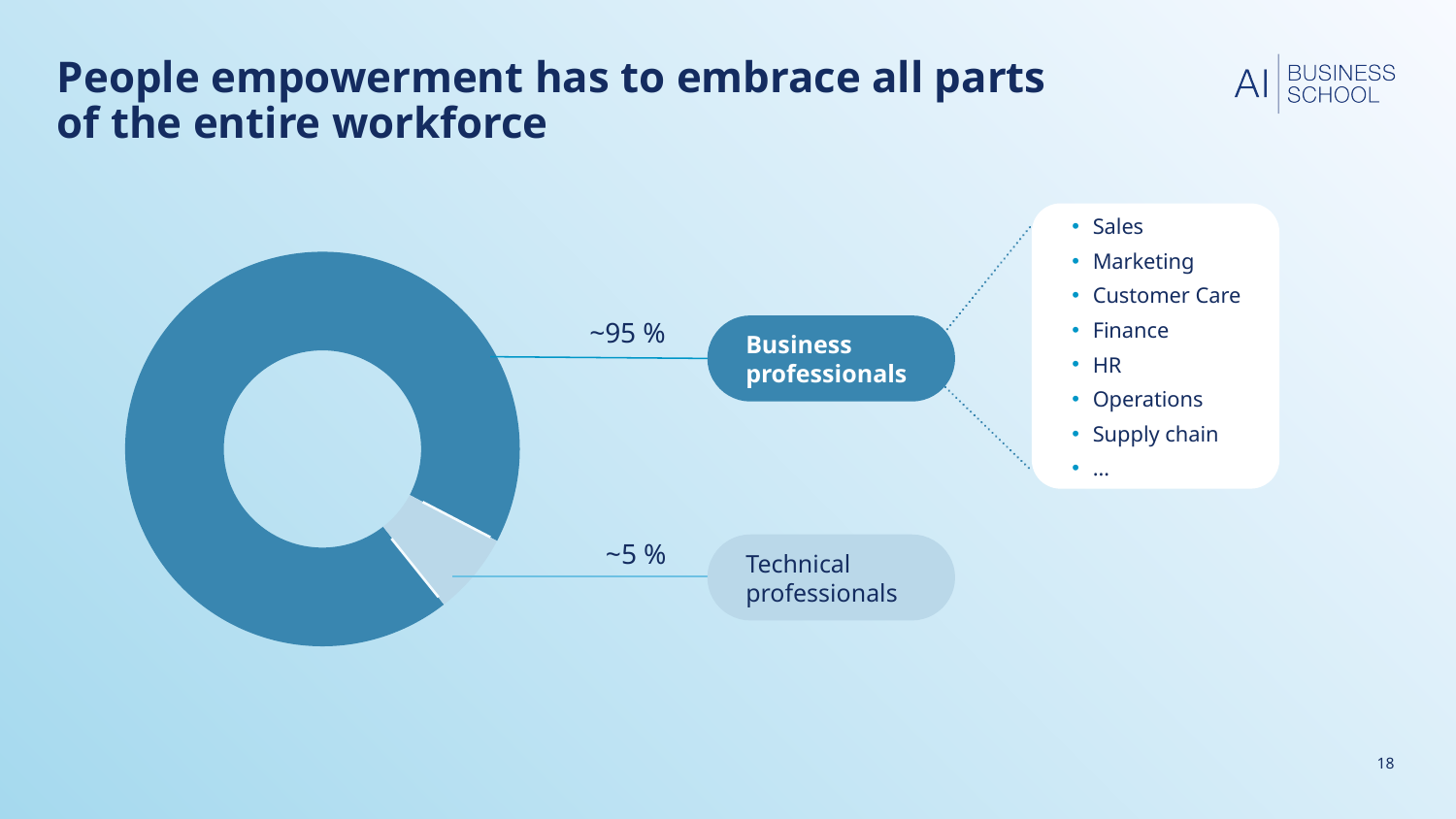
What value is labelled for the Technical professionals slice? ~5 % Which is larger in the pie chart, Business professionals or Technical professionals? Business professionals What value is labelled for the Business professionals slice? ~95 % Which slice of the pie chart is the smallest? Technical professionals What is the title of the slide containing the pie chart? People empowerment has to embrace all parts of the entire workforce What kind of chart is shown on the slide? pie chart (donut) How many slices does the pie chart have? 2 Which slice of the pie chart is drawn in the lighter blue colour? Technical professionals Which slice of the pie chart is the largest? Business professionals